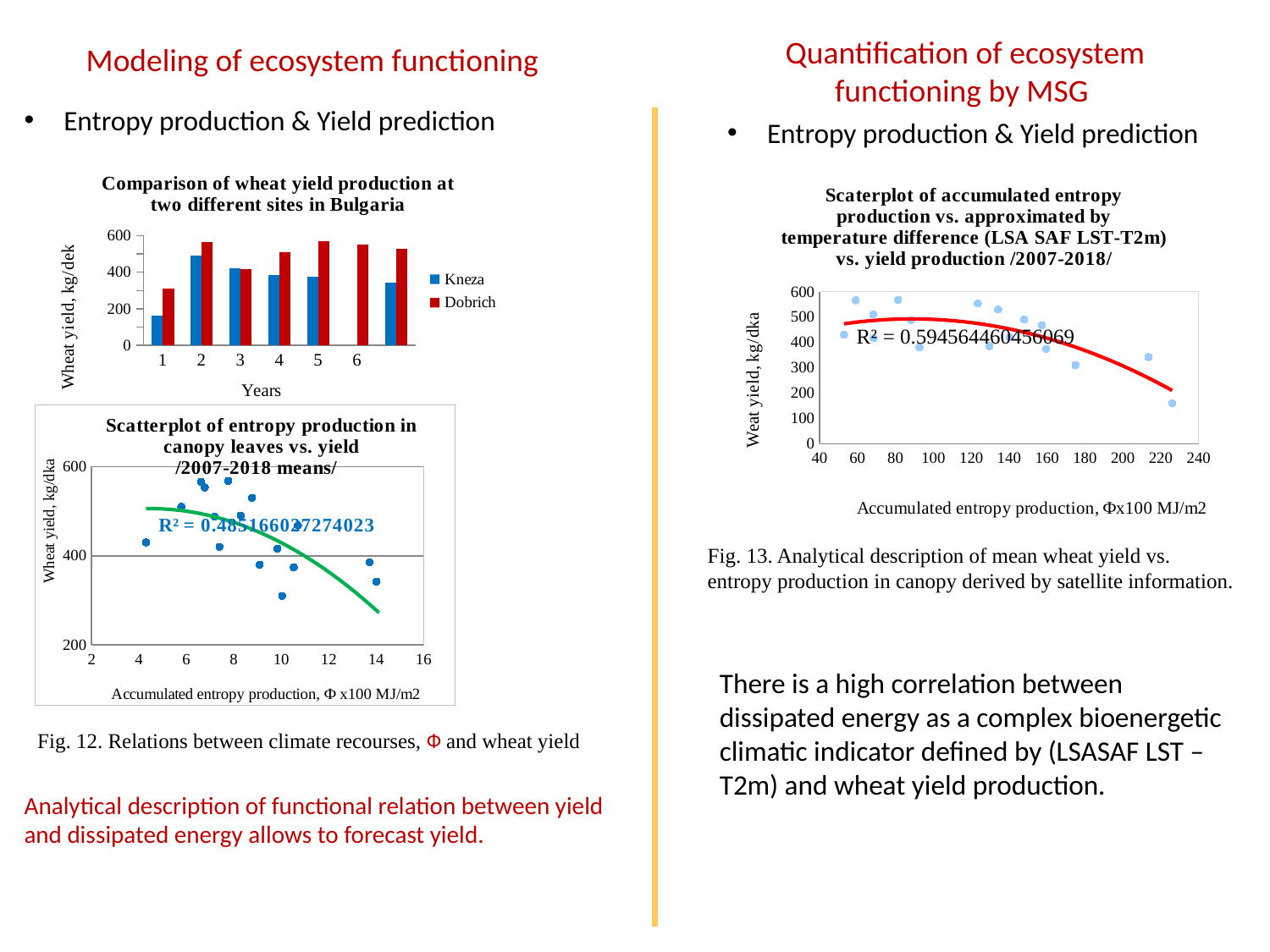
In the 'Comparison of wheat yield production at two different sites in Bulgaria' chart, which site has the larger value in year 4, Kneza or Dobrich? Dobrich In the 'Comparison of wheat yield production at two different sites in Bulgaria' chart, is the Kneza value for year 2 greater or less than 400? greater In the 'Comparison of wheat yield production at two different sites in Bulgaria' chart, which year has the lowest Dobrich value? 1 In the 'Comparison of wheat yield production at two different sites in Bulgaria' chart, which series is shown in red? Dobrich What R² value is printed on the 'Scaterplot of accumulated entropy production vs. approximated by temperature difference (LSA SAF LST-T2m) vs. yield production /2007-2018/' chart? 0.594564460456069 In the 'Comparison of wheat yield production at two different sites in Bulgaria' chart, how many year categories are shown on the x axis? 6 In the 'Comparison of wheat yield production at two different sites in Bulgaria' chart, which year has the highest Kneza value? 2 In the 'Scaterplot of accumulated entropy production vs. approximated by temperature difference (LSA SAF LST-T2m) vs. yield production /2007-2018/' chart, does the fitted trend line rise or fall as accumulated entropy production increases beyond 100? fall In the 'Comparison of wheat yield production at two different sites in Bulgaria' chart, is the Dobrich value for year 2 greater or less than 400? greater In the 'Comparison of wheat yield production at two different sites in Bulgaria' chart, is the Kneza value for year 1 greater or less than 200? less What kind of chart is the 'Comparison of wheat yield production at two different sites in Bulgaria' chart? bar chart How many series does the legend of the 'Comparison of wheat yield production at two different sites in Bulgaria' chart list? 2